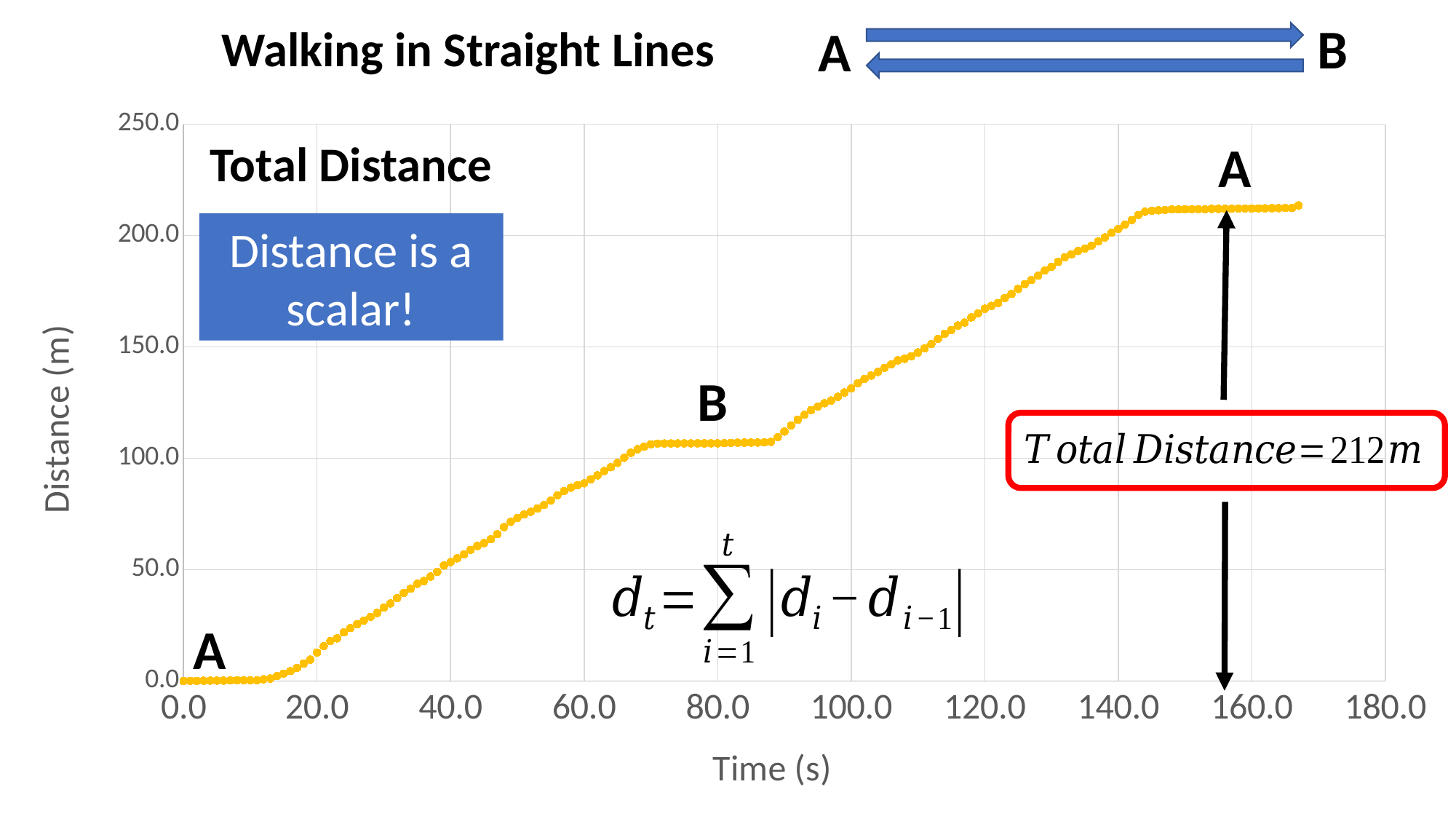
What kind of chart is shown on the slide? scatter chart Which is larger, the distance at 60.0 s or the distance at 100.0 s? 100.0 s What is the highest value shown on the y axis? 250.0 Is the distance at 40.0 s greater or less than 100? less What is the label of the y axis? Distance (m) Is the distance at 20.0 s greater or less than 50? less What total distance is stated in the red box on the chart? 212 m Is the distance at 120.0 s greater or less than 150? greater Does the plotted distance rise or fall as time increases along the x axis? rise What is the title of the chart? Total Distance